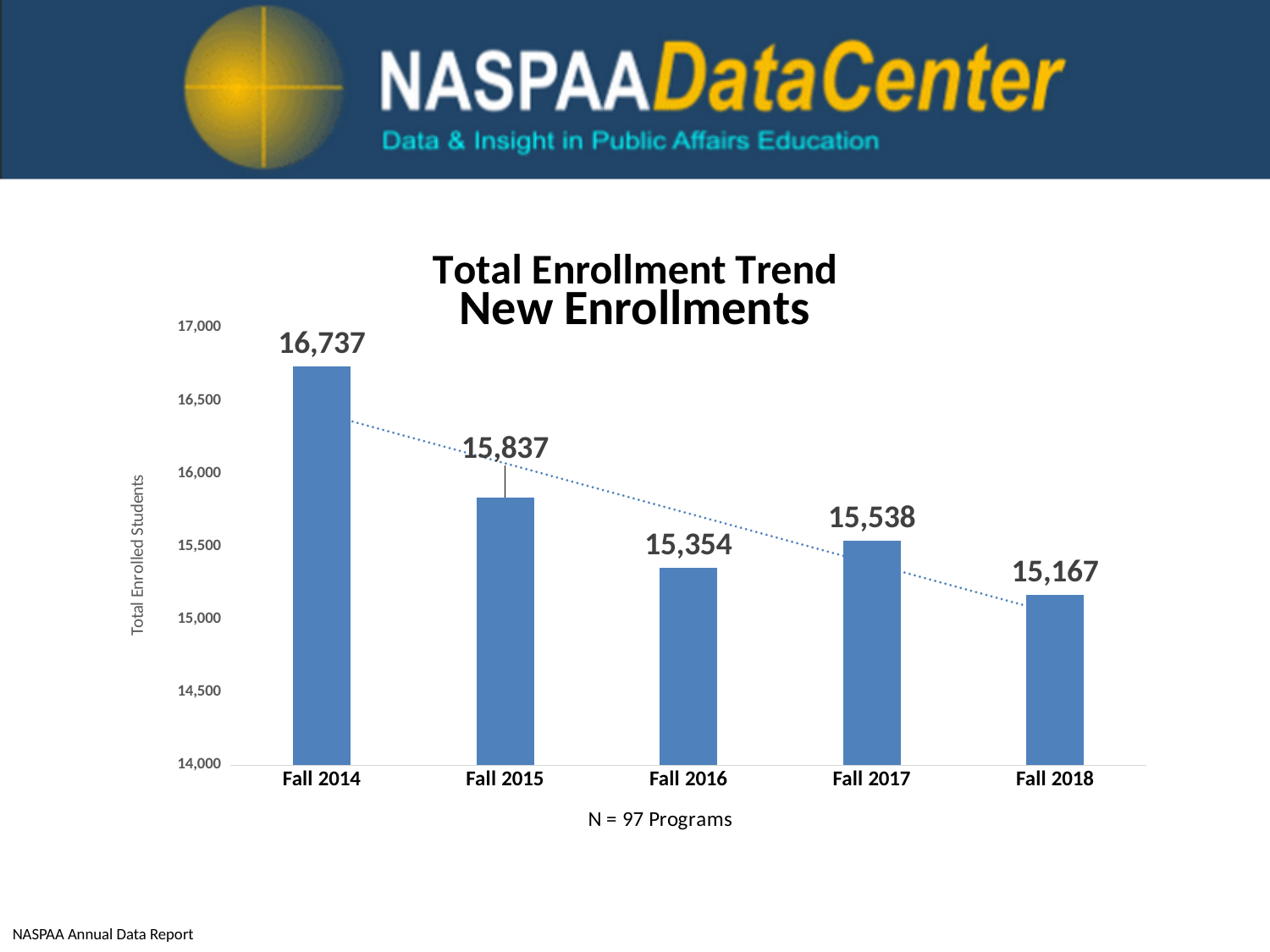
How many categories are shown on the x axis? 5 What is the value for Fall 2018? 15,167 Is the value for Fall 2016 greater or less than 15,500? less What kind of chart is shown on the slide? bar chart What is the value for Fall 2016? 15,354 What is the difference between the values for Fall 2014 and Fall 2018? 1,570 Which category has the lowest value? Fall 2018 Which is larger, the value for Fall 2015 or the value for Fall 2017? Fall 2015 What is the label of the y axis? Total Enrolled Students What is the value for Fall 2014? 16,737 What is the difference between the values for Fall 2017 and Fall 2016? 184 Which category has the highest value? Fall 2014